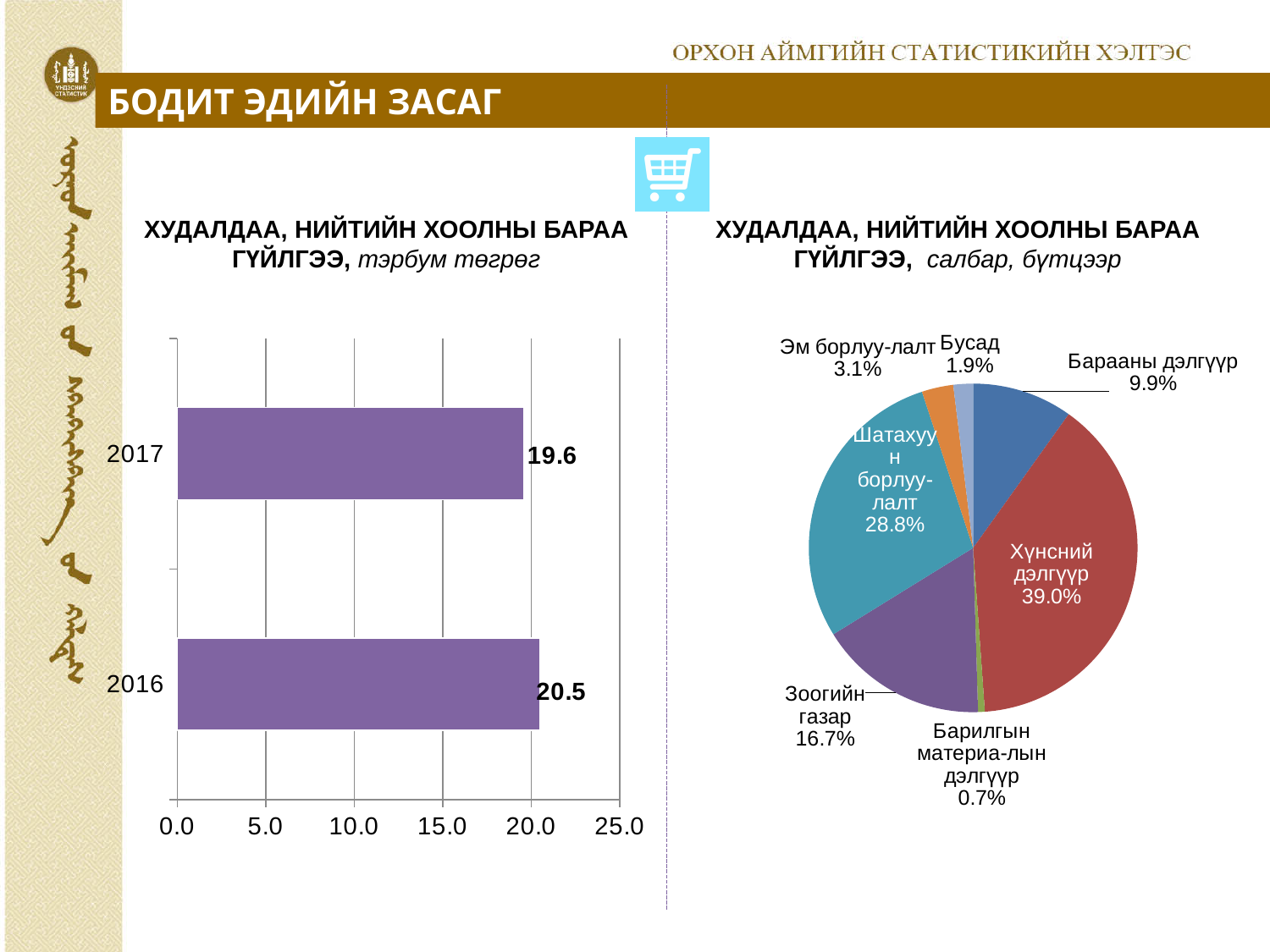
In the right pie chart, what share does Хүнсний дэлгүүр have? 39.0% In the left bar chart, which year has the higher value, 2016 or 2017? 2016 What kind of chart is on the left side of the slide? Bar chart In the right pie chart, how many slices are there? 7 In the left bar chart, what is the value for 2016? 20.5 In the left bar chart, what is the value for 2017? 19.6 In the left bar chart, how many years are shown? 2 In the right pie chart, what share does Шатахуун борлуулалт have? 28.8% In the left bar chart, what is the difference between the 2016 and 2017 values? 0.9 In the right pie chart, what is the difference between the shares of Зоогийн газар and Барааны дэлгүүр? 6.8% In the right pie chart, which category has the largest share? Хүнсний дэлгүүр In the right pie chart, which category has the smallest share? Барилгын материалын дэлгүүр